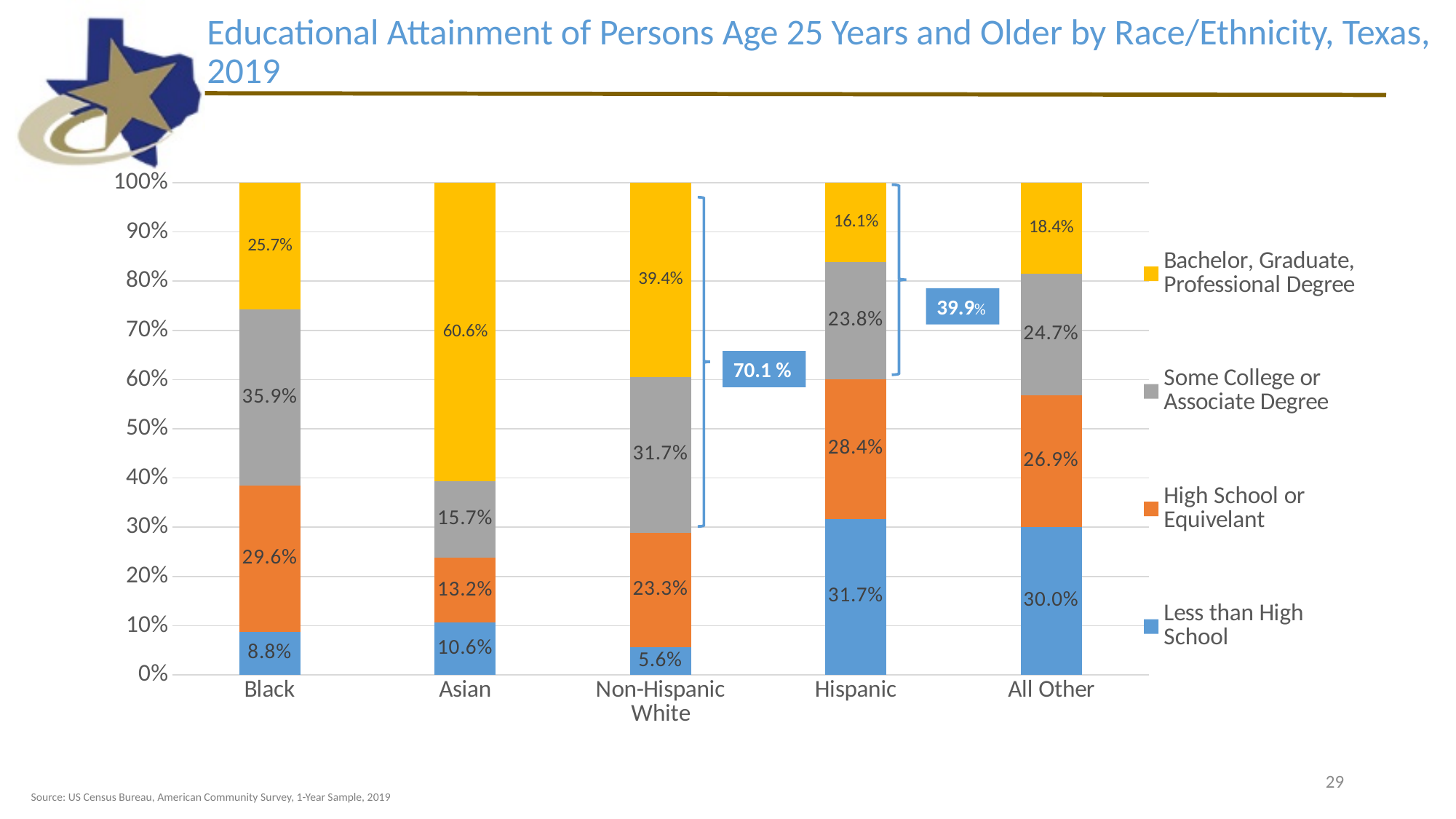
Which race/ethnicity group has the highest share with a Bachelor, Graduate, or Professional Degree? Asian How many educational attainment series does the legend list? 4 What is the Less than High School share for Hispanic persons? 31.7% What is the Some College or Associate Degree share for the All Other group? 24.7% Which group has the highest Some College or Associate Degree share? Black How many percentage points higher is the Bachelor, Graduate, Professional Degree share for Asian than for Black? 34.9 percentage points What percentage of Asians age 25 and older have a Bachelor, Graduate, or Professional Degree? 60.6% What colour represents Less than High School in the chart? Blue What kind of chart is shown on the slide? Stacked bar chart How many race/ethnicity categories are shown on the x axis? 5 Which race/ethnicity group has the lowest Less than High School share? Non-Hispanic White Which is larger: the High School or Equivalent share for Black or for Hispanic? Black